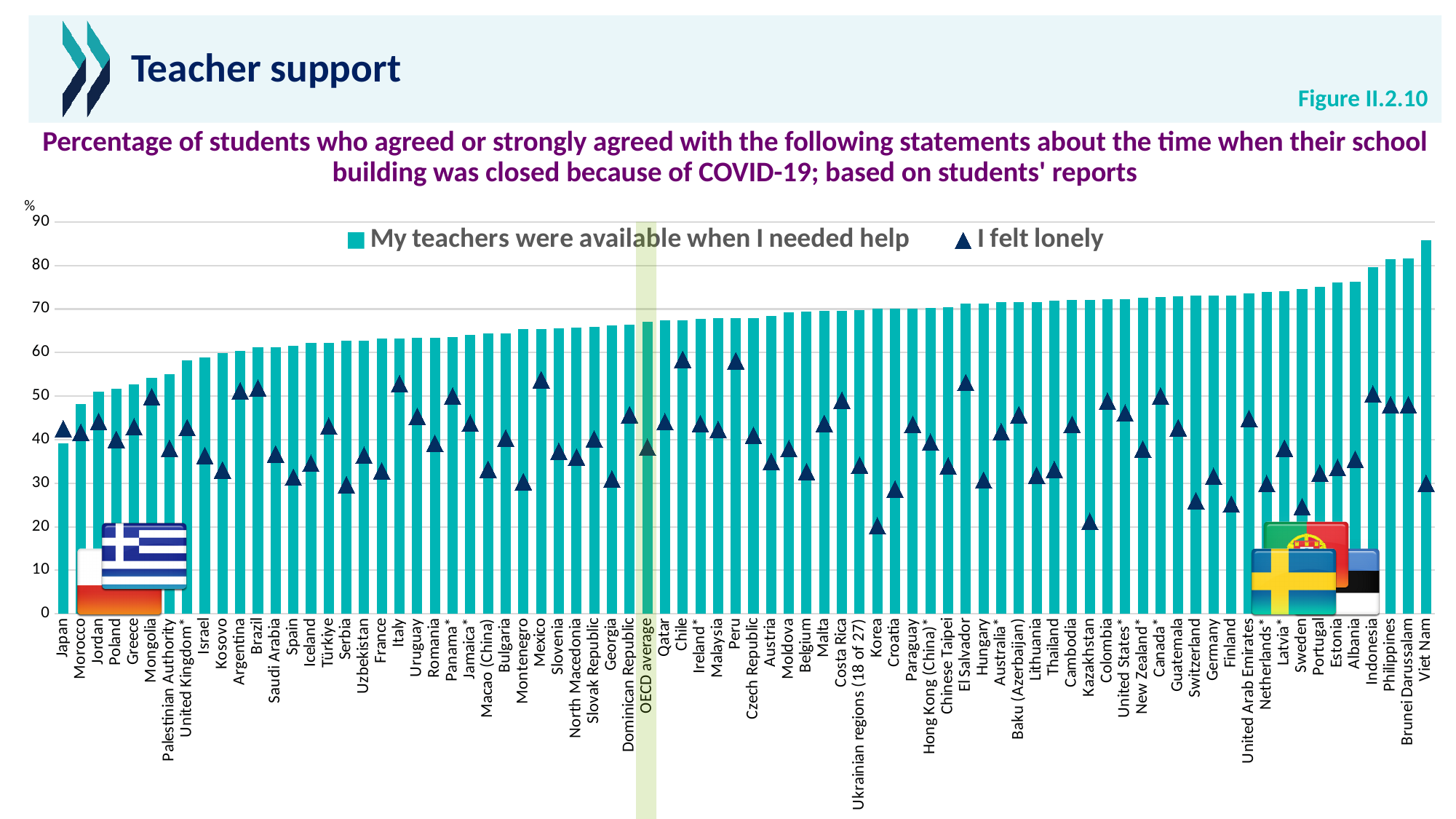
Which series is shown with triangle markers? I felt lonely Is the 'I felt lonely' value for Chile greater or less than 50? greater Do the bars for 'My teachers were available when I needed help' rise or fall from left to right? rise Is the bar for Japan greater or less than 50? less Is the 'I felt lonely' value for Korea greater or less than 30? less Which country has the highest bar for 'My teachers were available when I needed help'? Viet Nam What kind of chart is shown on the slide? bar chart Which has the larger 'I felt lonely' value, Chile or Korea? Chile How many series does the legend list? 2 Which country has the lowest bar for 'My teachers were available when I needed help'? Japan